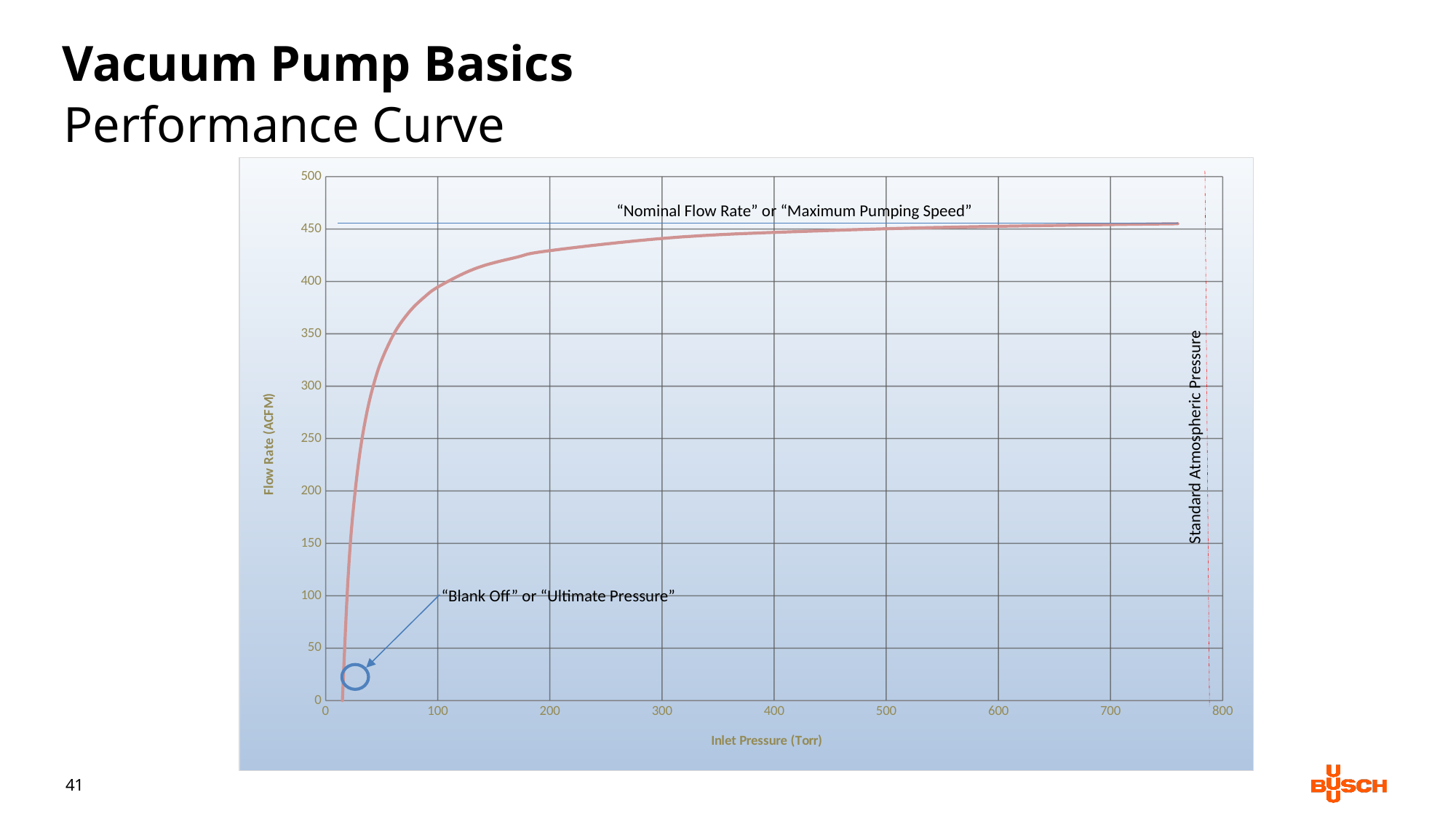
Is the flow rate at an inlet pressure of 200 Torr greater or less than 450? less What kind of chart is shown on the slide? line chart Is the flow rate at an inlet pressure of 700 Torr greater or less than 400? greater Does the flow rate rise or fall as inlet pressure increases along the x axis? rise Is the flow rate at an inlet pressure of 600 Torr greater or less than 500? less What is the highest value shown on the y axis? 500 What is the label of the y axis? Flow Rate (ACFM) What is the label of the x axis? Inlet Pressure (Torr) Which is larger, the flow rate at 100 Torr or the flow rate at 500 Torr? 500 Torr